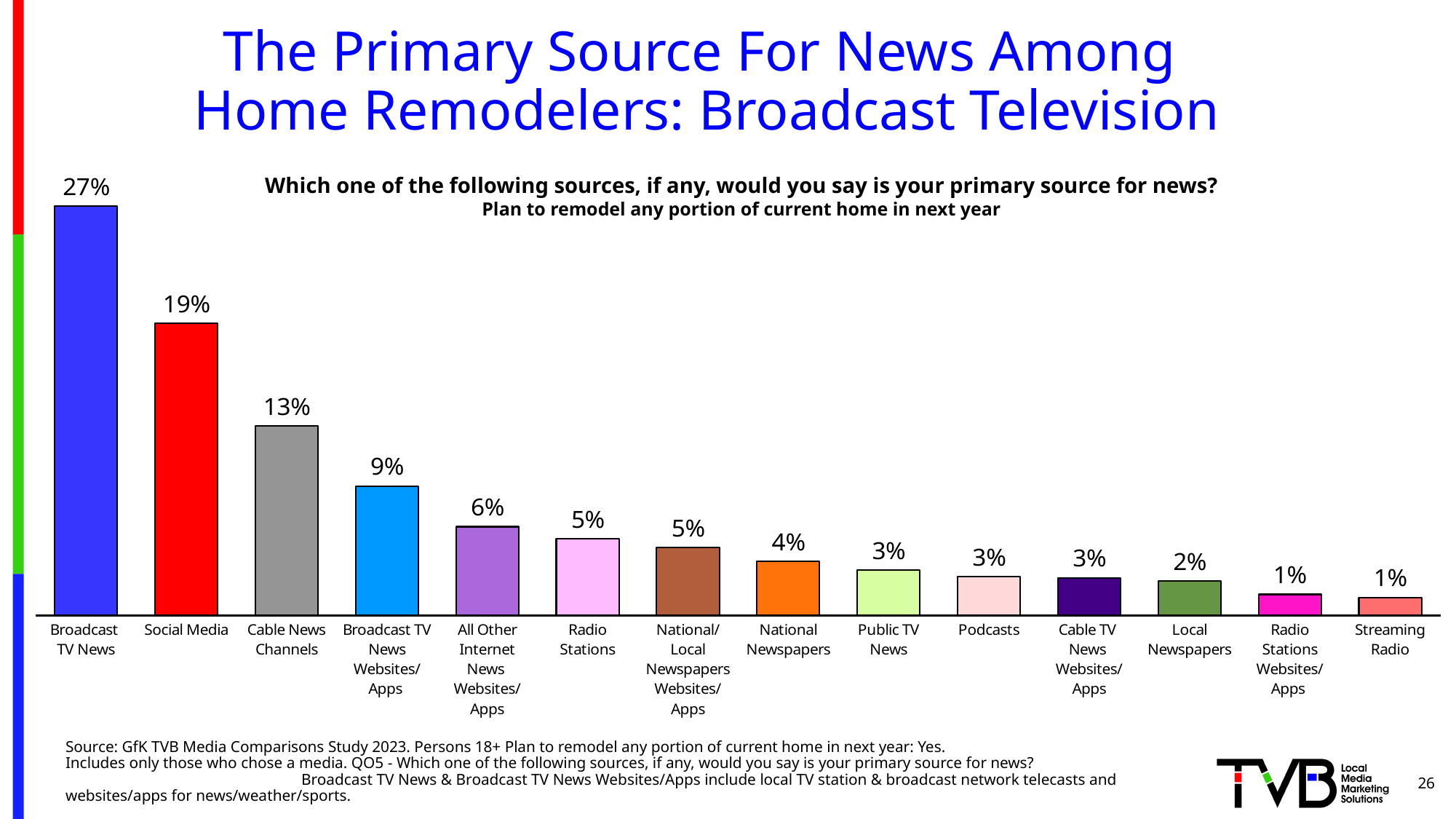
How many news sources (categories) are shown on the chart? 14 What is the difference in percentage points between Broadcast TV News and Social Media? 8 What is the difference in percentage points between Cable News Channels and Broadcast TV News Websites/Apps? 4 What kind of chart is shown on the slide? Bar chart What is the value shown for Broadcast TV News Websites/Apps? 9% Which source has the highest percentage on the chart? Broadcast TV News What percentage of home remodelers say Broadcast TV News is their primary source for news? 27% What is the value shown for Local Newspapers? 2% What is the value shown for Cable News Channels? 13% Do the values rise or fall moving from left to right across the chart? Fall What is the value shown for Social Media? 19% Which is larger, the value for Radio Stations or the value for National Newspapers? Radio Stations